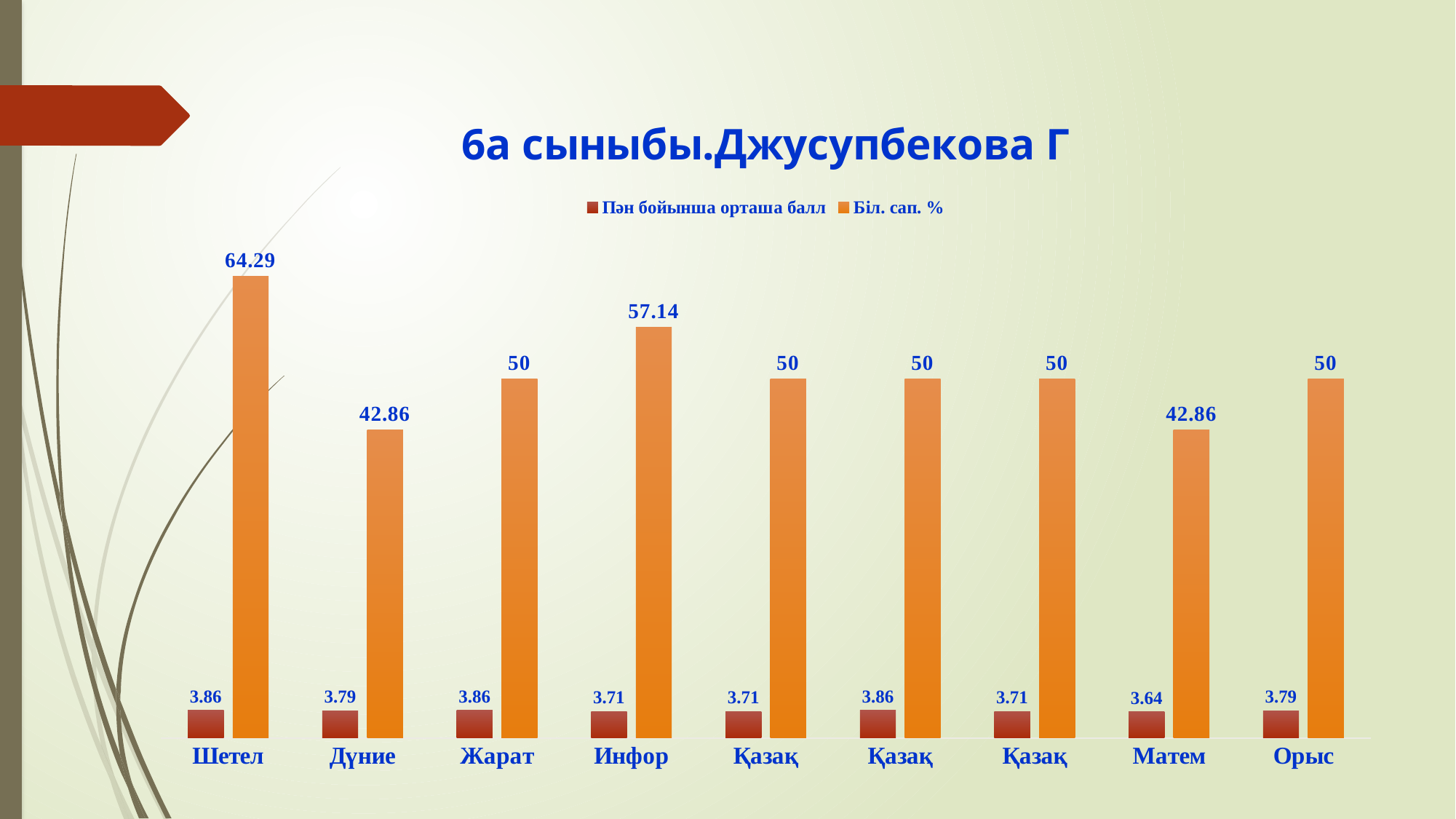
What is the value of "Біл. сап. %" for Инфор? 57.14 Which category has the lowest value of "Пән бойынша орташа балл"? Матем What is the title of the slide? 6а сыныбы.Джусупбекова Г How many categories are shown on the x axis? 9 What is the difference between the "Біл. сап. %" values for Шетел and Дүние? 21.43 How many series does the legend list? 2 What is the value of "Біл. сап. %" for Шетел? 64.29 What is the value of "Пән бойынша орташа балл" for Орыс? 3.79 What kind of chart is shown on the slide? Bar chart Which category has the highest value of "Біл. сап. %"? Шетел What is the value of "Пән бойынша орташа балл" for Матем? 3.64 Which has a larger "Біл. сап. %" value, Инфор or Жарат? Инфор